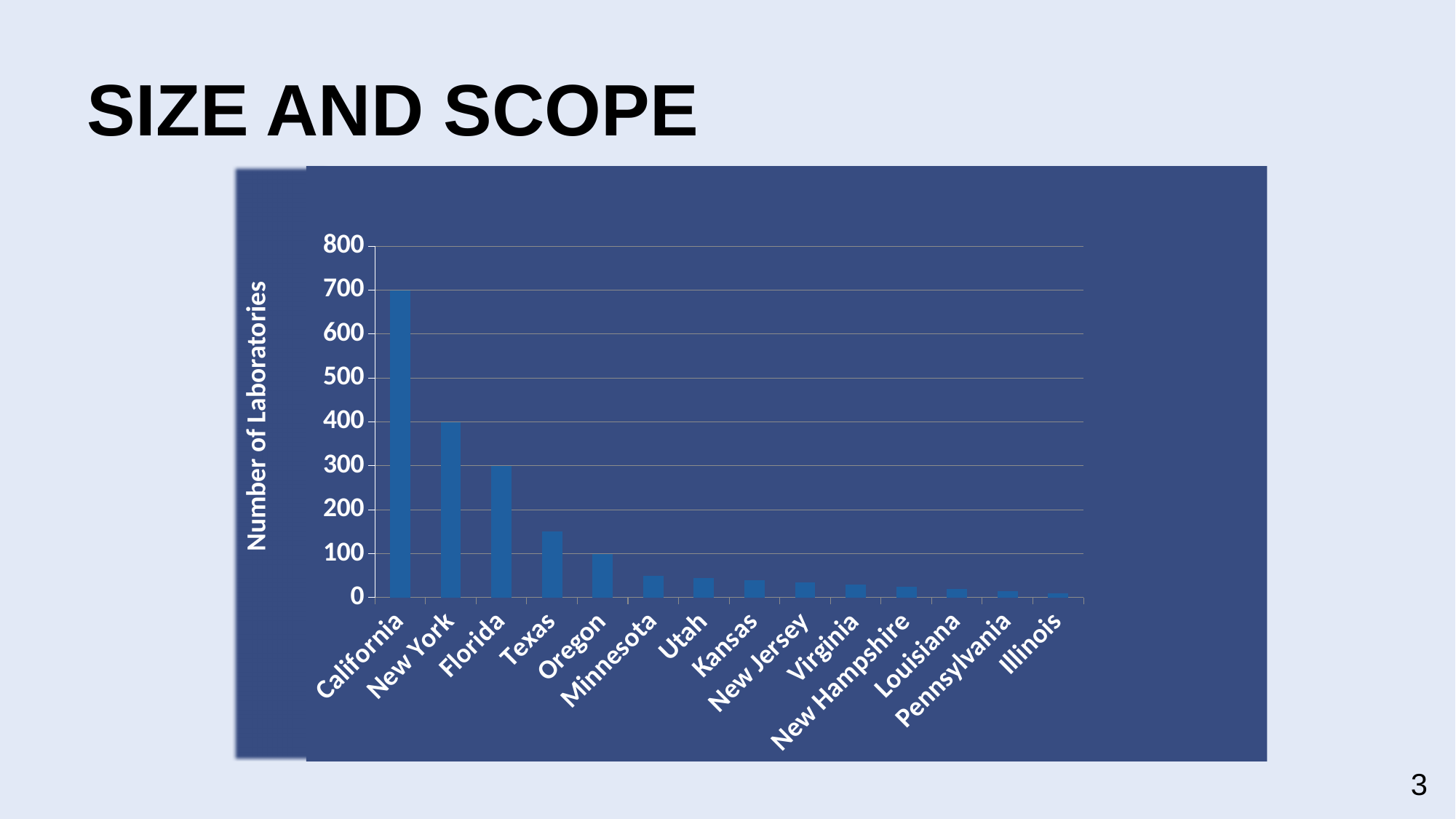
What is the number of laboratories for California? 700 Which state has the highest number of laboratories? California What is the number of laboratories for New York? 400 Is the value for Florida greater or less than 200? greater Is the value for Minnesota greater or less than 100? less Do the values rise or fall moving from left to right along the x axis? fall How many states are shown on the x axis? 14 Which has more laboratories, Texas or Oregon? Texas Is the value for Texas greater or less than 200? less Which state has the lowest number of laboratories? Illinois What kind of chart is shown on the slide? bar chart What is the label of the vertical axis? Number of Laboratories